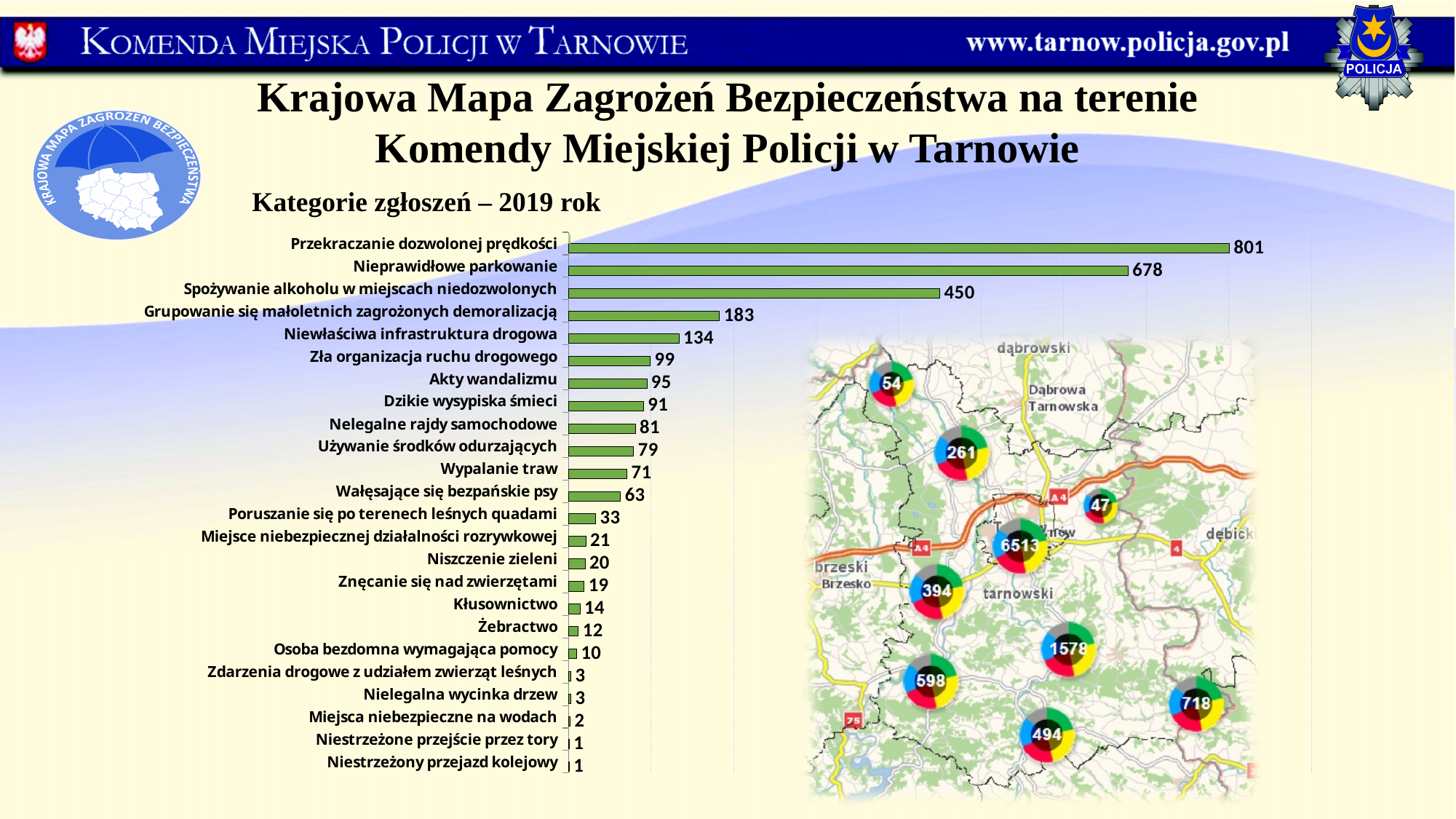
What is the difference between Przekraczanie dozwolonej prędkości and Nieprawidłowe parkowanie? 123 What kind of chart is used to show the report categories? Bar chart What is the subtitle above the chart? Kategorie zgłoszeń – 2019 rok What is the lowest value shown in the chart? 1 What is the value for Spożywanie alkoholu w miejscach niedozwolonych? 450 Which is larger, Wypalanie traw or Wałęsające się bezpańskie psy? Wypalanie traw What is the difference between Grupowanie się małoletnich zagrożonych demoralizacją and Niewłaściwa infrastruktura drogowa? 49 How many categories are shown in the bar chart? 24 What is the value for Akty wandalizmu? 95 What is the value for Kłusownictwo? 14 Which category has the highest value? Przekraczanie dozwolonej prędkości What is the value for Nieprawidłowe parkowanie? 678